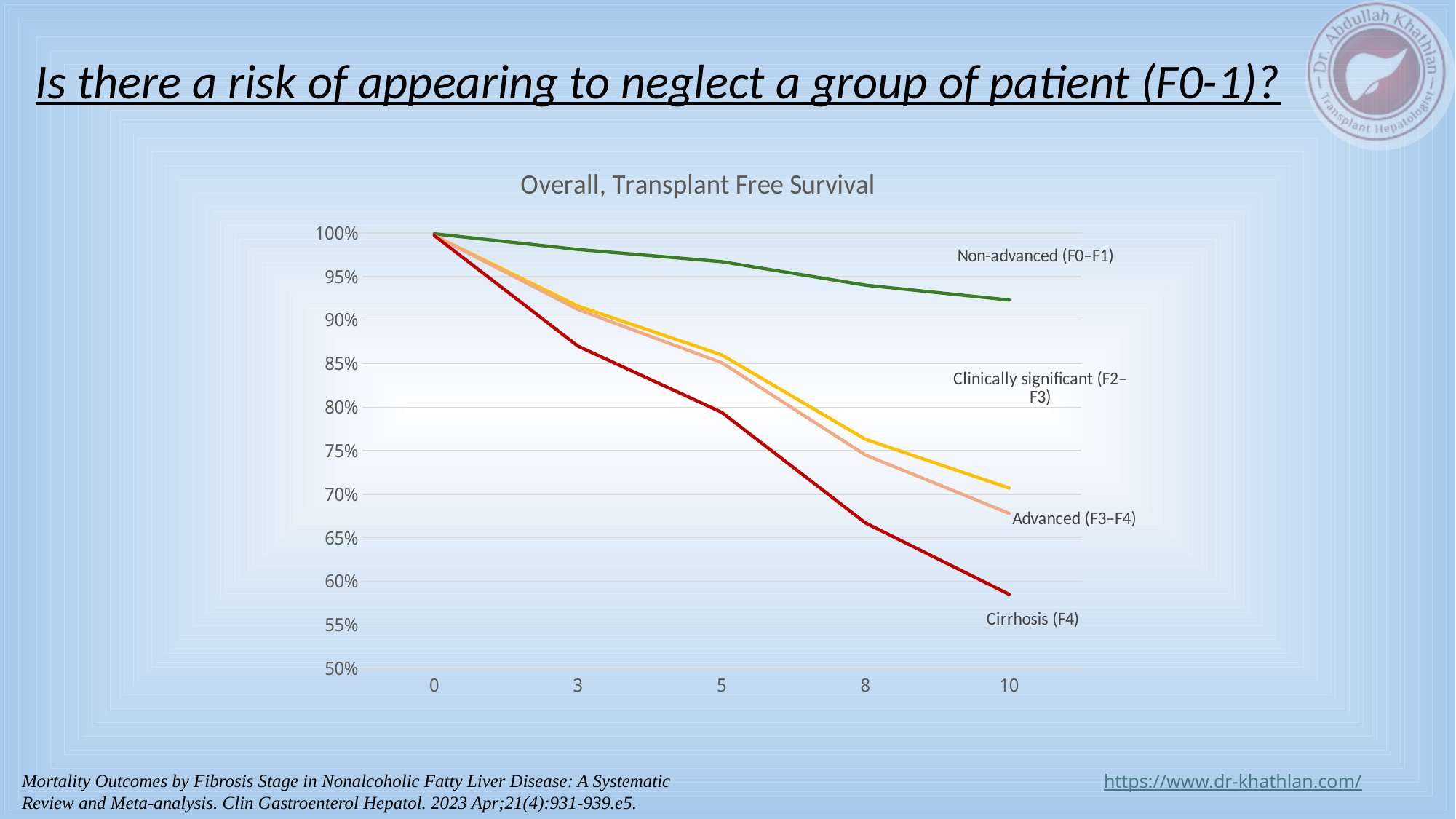
Do the survival values rise or fall as time increases along the x axis? fall Is the value for Cirrhosis (F4) at year 10 greater or less than 60%? less What colour is the line for Cirrhosis (F4)? red Which group has the lowest transplant-free survival at year 10? Cirrhosis (F4) What type of chart is shown on the slide? line chart Is the value for Non-advanced (F0–F1) at year 10 greater or less than 90%? greater Which group has the highest transplant-free survival at year 10? Non-advanced (F0–F1) How many time points are shown on the x axis? 5 How many series (patient groups) are plotted on the chart? 4 What is the title of the chart? Overall, Transplant Free Survival At year 8, which is larger: the value for Non-advanced (F0–F1) or the value for Cirrhosis (F4)? Non-advanced (F0–F1)